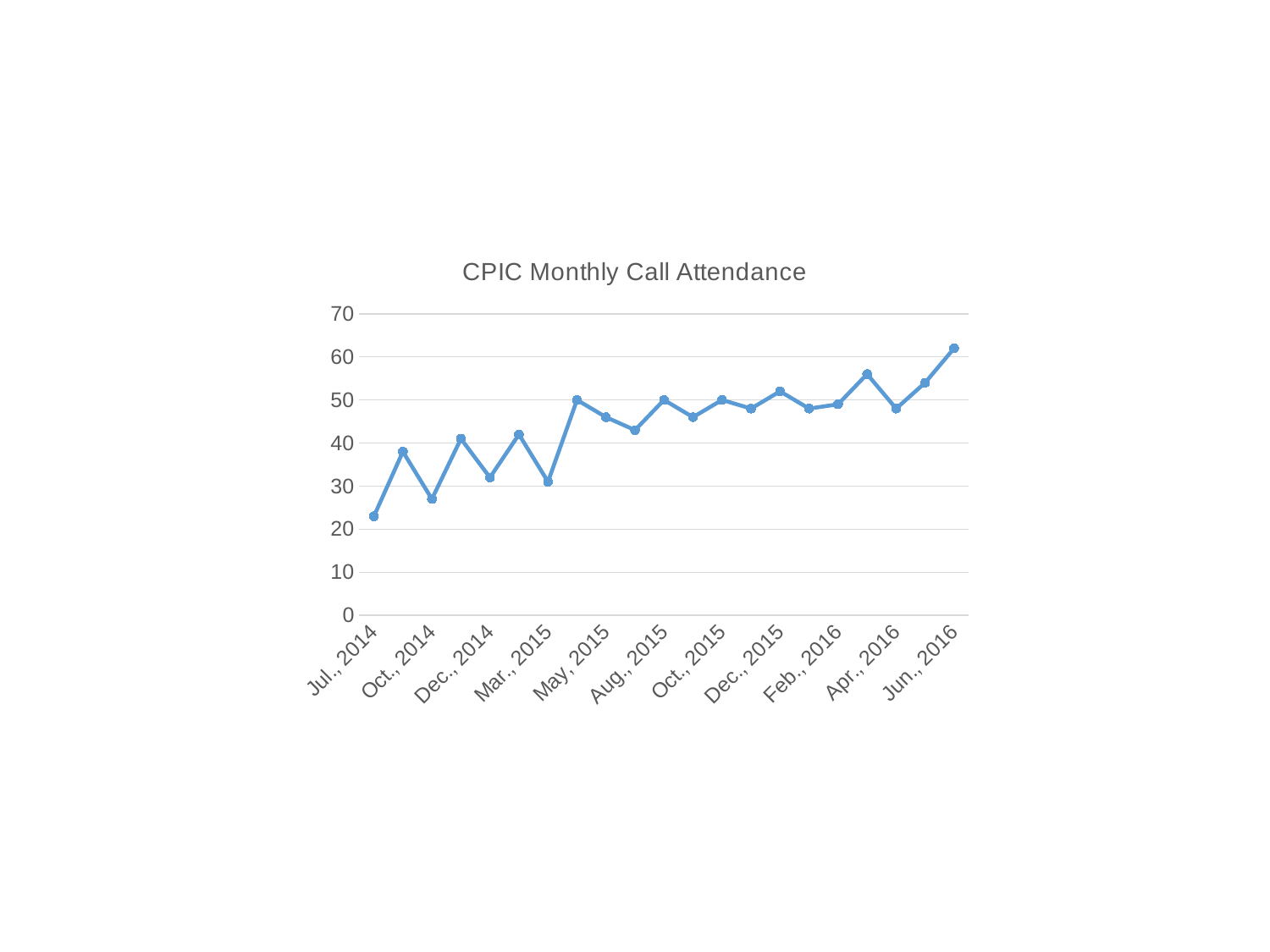
What kind of chart is shown on the slide? line chart What is the title of the chart? CPIC Monthly Call Attendance Overall, do the values rise or fall from Jul., 2014 to Jun., 2016? rise Which is larger, the value for Jul., 2014 or the value for Jun., 2016? Jun., 2016 Which labelled month has the lowest call attendance? Jul., 2014 Is the value for Feb., 2016 greater or less than 40? greater Is the value for Jun., 2016 greater or less than 60? greater Is the value for Jul., 2014 greater or less than 30? less Which labelled month has the highest call attendance? Jun., 2016 How many month labels are shown on the x axis? 11 Which is larger, the value for Mar., 2015 or the value for May, 2015? May, 2015